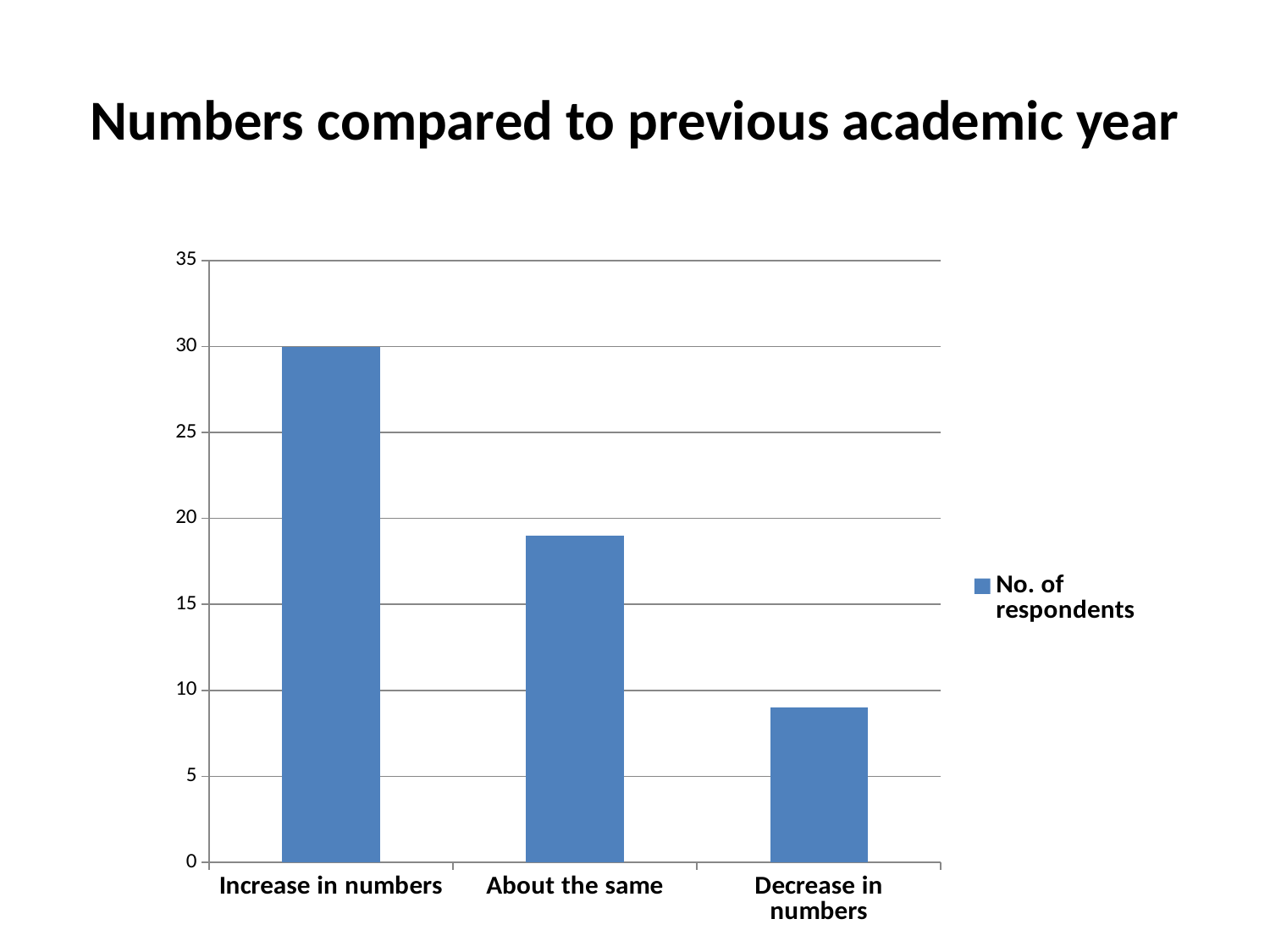
How many series does the legend list? 1 Which has more respondents, 'About the same' or 'Decrease in numbers'? About the same Do the values rise or fall moving from left to right along the x axis? fall What series name is shown in the legend? No. of respondents Is the value for 'About the same' greater or less than 20? less Which category has the lowest number of respondents? Decrease in numbers What is the number of respondents for 'Increase in numbers'? 30 What kind of chart is shown on the slide? bar chart What is the title of the chart? Numbers compared to previous academic year Is the value for 'Decrease in numbers' greater or less than 10? less How many categories are shown on the x axis? 3 Which category has the highest number of respondents? Increase in numbers